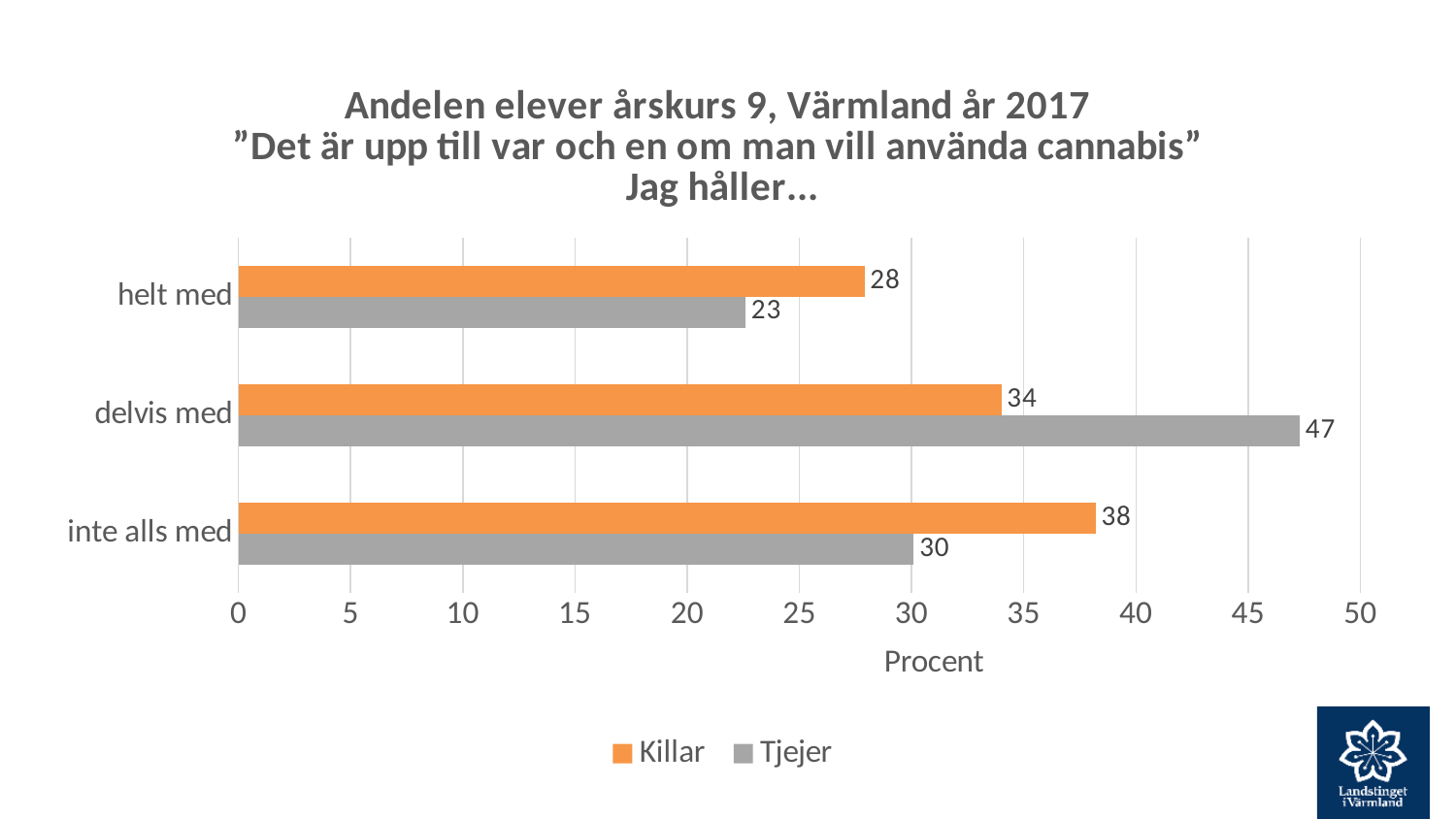
What is the value for Tjejer in the "inte alls med" category? 30 Which category has the highest value for Tjejer? delvis med How many categories are shown on the chart? 3 What is the value for Killar in the "helt med" category? 28 What kind of chart is shown on the slide? bar chart How many series does the legend list? 2 In the "inte alls med" category, which series has the larger value, Killar or Tjejer? Killar What is the value for Tjejer in the "delvis med" category? 47 What is the label of the horizontal axis? Procent What is the difference between Tjejer and Killar in the "delvis med" category? 13 Which category has the lowest value for Killar? helt med Is the value for Tjejer in the "helt med" category greater or less than 25? less